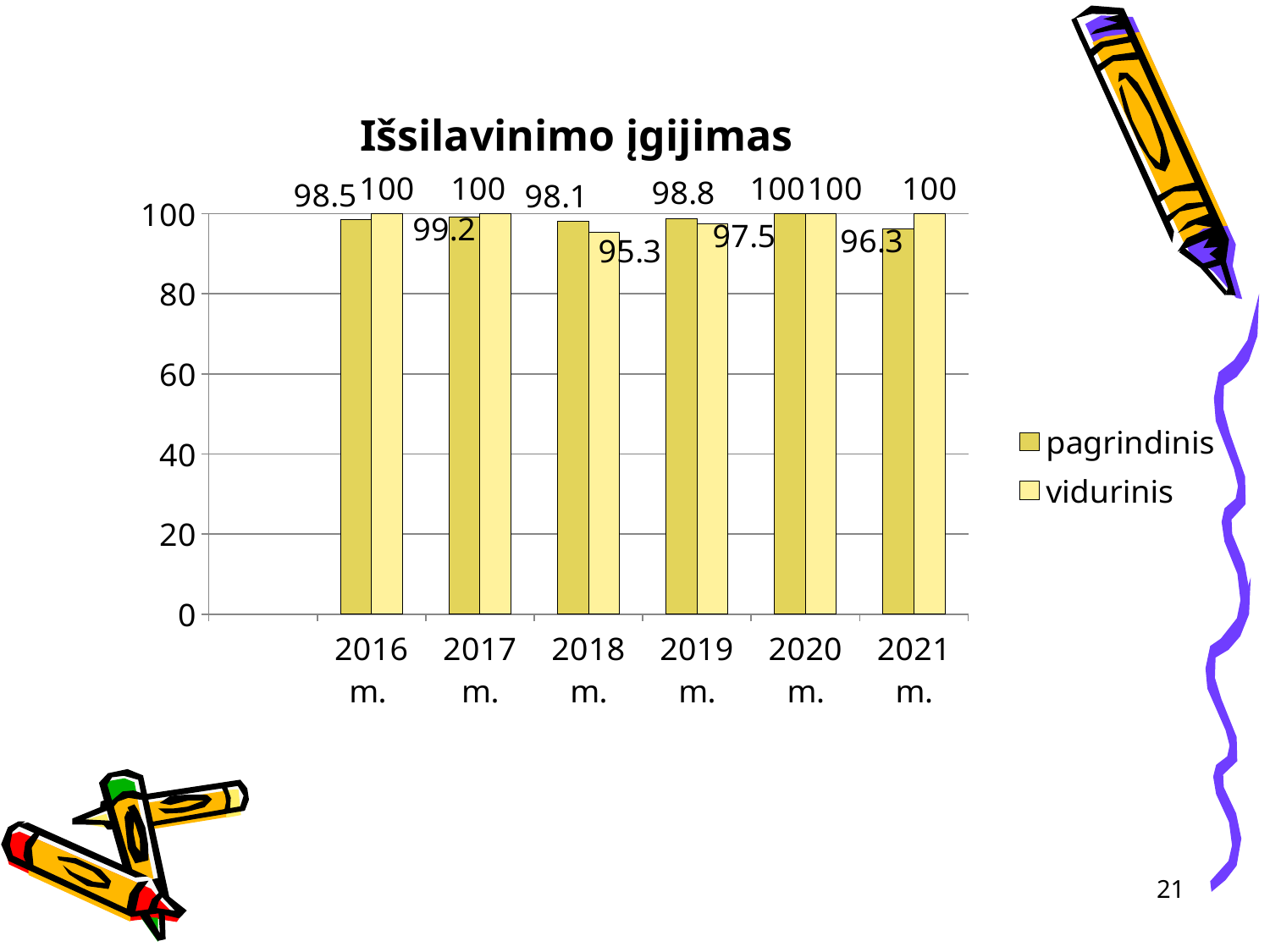
What is the value for vidurinis in 2018 m.? 95.3 How many years are shown on the x axis? 6 In which year is the pagrindinis value the lowest? 2021 m. How many series does the legend list? 2 What is the value for pagrindinis in 2016 m.? 98.5 In which year is the vidurinis value the lowest? 2018 m. What is the difference between the vidurinis and pagrindinis values in 2021 m.? 3.7 In 2018 m., which series has the larger value, pagrindinis or vidurinis? pagrindinis In which year does pagrindinis reach its highest value? 2020 m. What type of chart is shown on the slide? bar chart What is the value for vidurinis in 2019 m.? 97.5 What is the value for pagrindinis in 2021 m.? 96.3